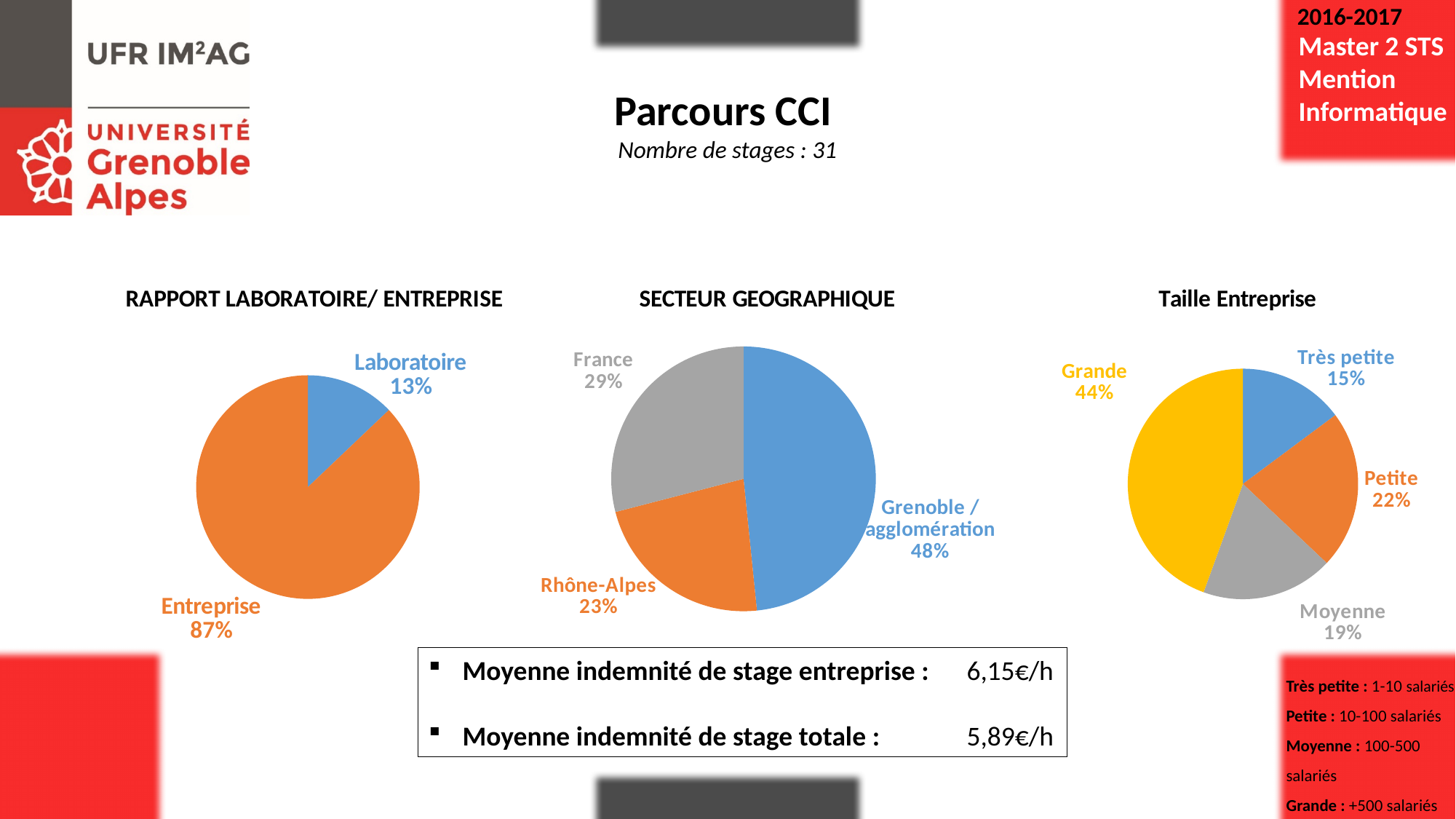
In the 'Taille Entreprise' chart, which category has the largest slice? Grande In the 'SECTEUR GEOGRAPHIQUE' chart, how many categories are shown? 3 In the 'SECTEUR GEOGRAPHIQUE' chart, what is the difference between the France share and the Rhône-Alpes share? 6% In the 'SECTEUR GEOGRAPHIQUE' chart, what share is labelled for Rhône-Alpes? 23% In the 'RAPPORT LABORATOIRE/ ENTREPRISE' chart, what share is labelled for Entreprise? 87% In the 'Taille Entreprise' chart, what share is labelled for Moyenne? 19% In the 'SECTEUR GEOGRAPHIQUE' chart, which category has the smallest slice? Rhône-Alpes What kind of chart is the 'SECTEUR GEOGRAPHIQUE' chart? pie chart In the 'RAPPORT LABORATOIRE/ ENTREPRISE' chart, what share is labelled for Laboratoire? 13% In the 'Taille Entreprise' chart, which is larger, Petite or Très petite? Petite In the 'SECTEUR GEOGRAPHIQUE' chart, which category has the largest slice? Grenoble / agglomération In the 'Taille Entreprise' chart, how many categories are shown? 4